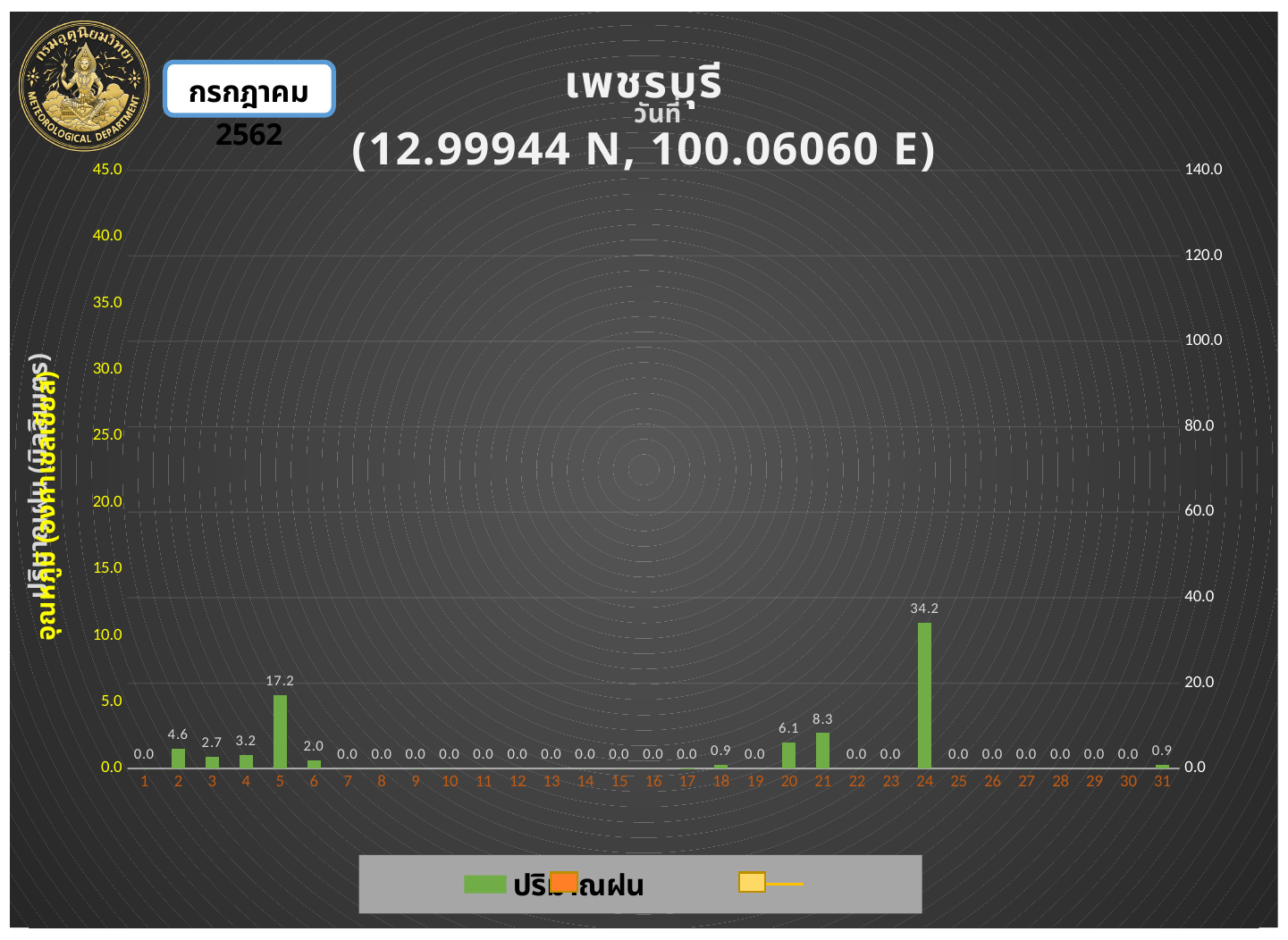
What is the rainfall value on day 5? 17.2 What is the difference between the rainfall values on day 24 and day 5? 17.0 Which day has the highest rainfall value? 24 What is the difference between the rainfall values on day 21 and day 20? 2.2 What colour are the rainfall (ปริมาณฝน) bars? green How many days (categories) are shown on the x axis? 31 What is the rainfall value on day 21? 8.3 What is the rainfall value (ปริมาณฝน) on day 24? 34.2 What kind of chart is used to show the rainfall data? bar chart Which is larger, the rainfall value on day 3 or on day 4? day 4 What is the rainfall value on day 31? 0.9 What is the rainfall value on day 2? 4.6